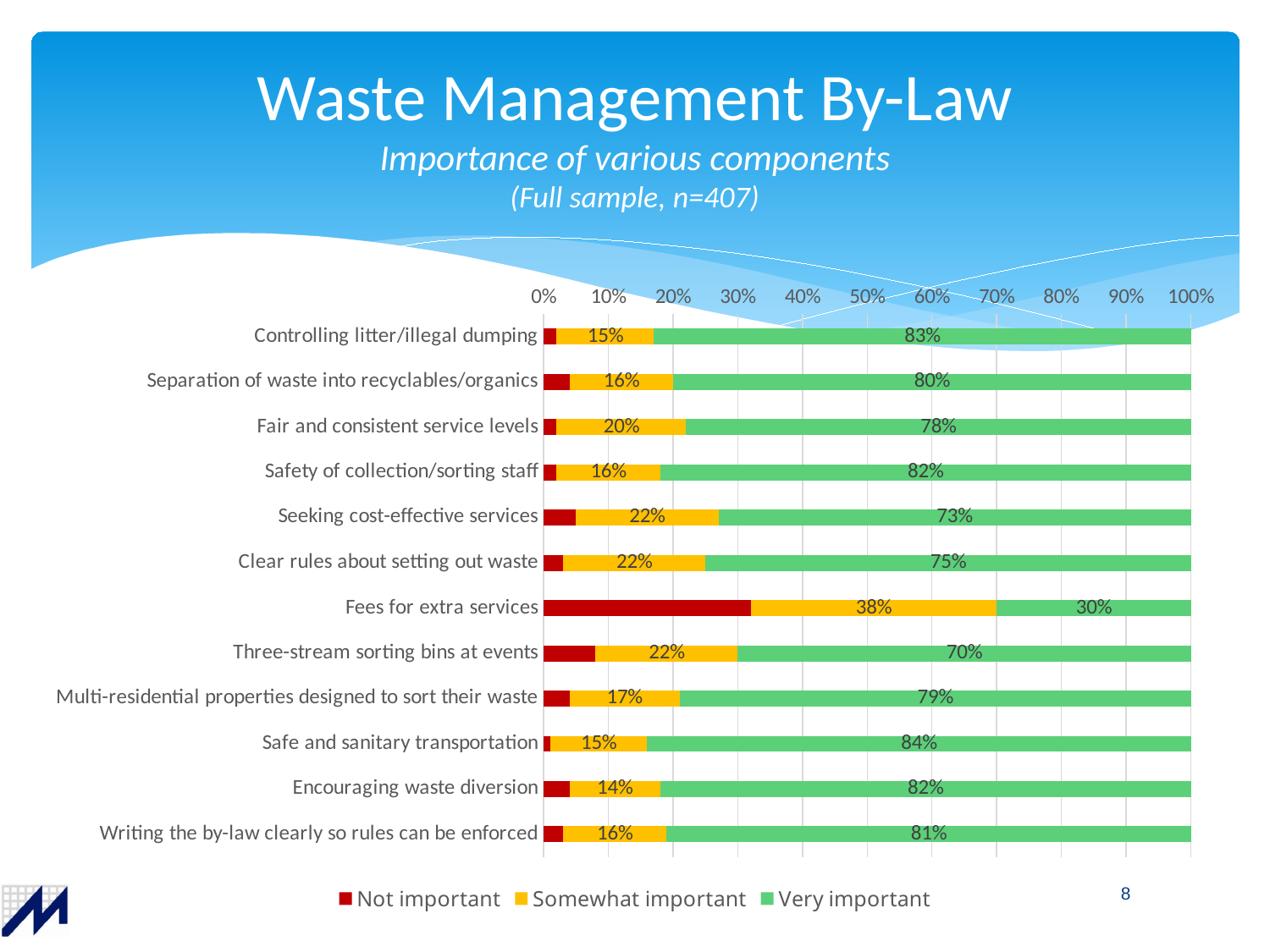
What percentage rated 'Controlling litter/illegal dumping' as Very important? 83% Which component has the highest Very important percentage? Safe and sanitary transportation Which has a higher Very important percentage: 'Fair and consistent service levels' or 'Safety of collection/sorting staff'? Safety of collection/sorting staff Which component has the highest Somewhat important percentage? Fees for extra services What is the difference in Very important percentage between 'Controlling litter/illegal dumping' and 'Fees for extra services'? 53 percentage points How many components are listed in the chart? 12 What is the Very important value for 'Safe and sanitary transportation'? 84% How many series does the legend list? 3 What percentage rated 'Fees for extra services' as Somewhat important? 38% Which component has the lowest Very important percentage? Fees for extra services Is the Not important value for 'Fees for extra services' greater or less than 20%? greater What type of chart is shown on the slide? Stacked bar chart